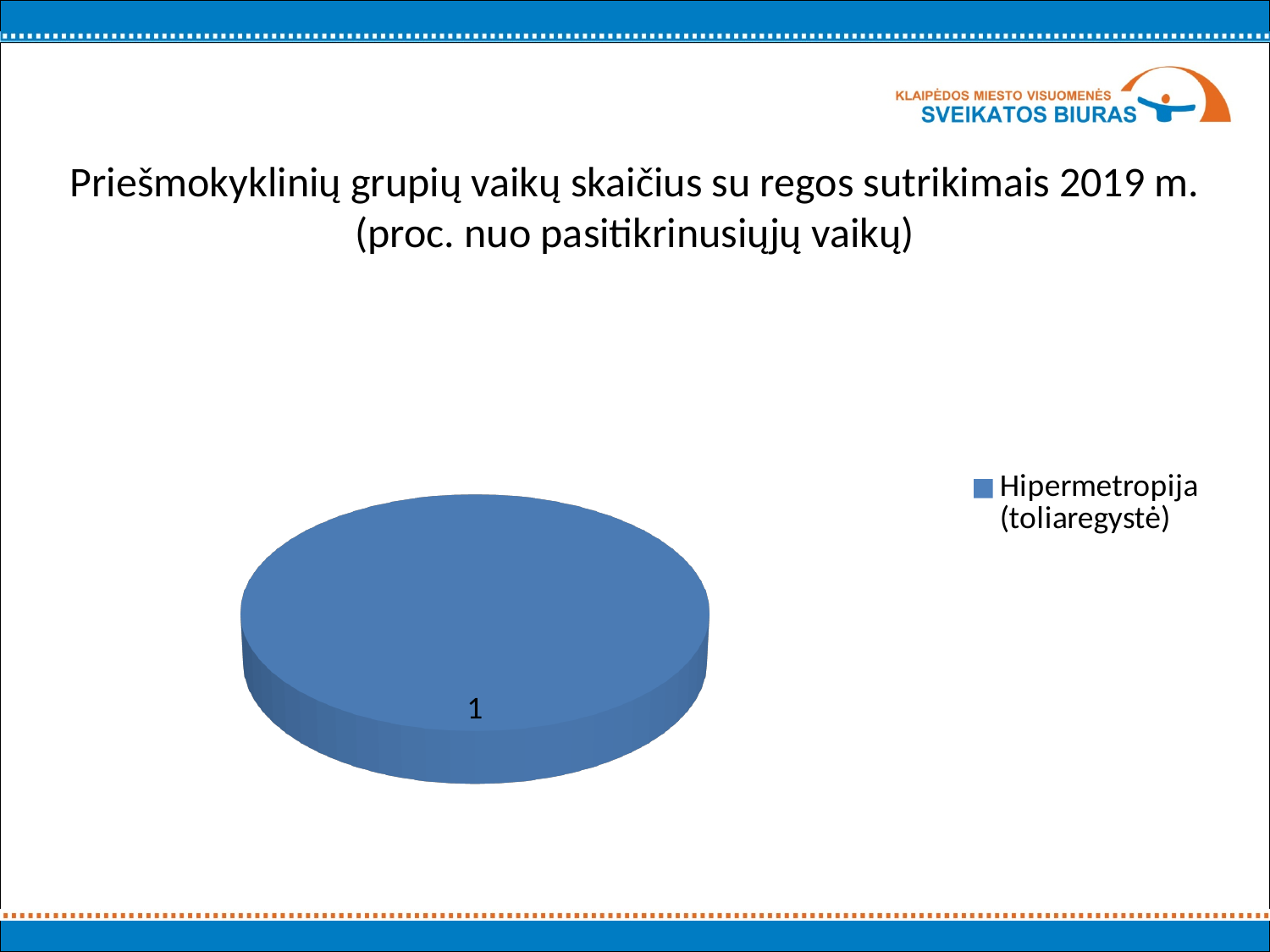
What share of the pie does the Hipermetropija (toliaregystė) slice take up? 100% What value is printed on the slice for Hipermetropija (toliaregystė)? 1 What kind of chart is shown on the slide? pie chart How many entries does the legend of the pie chart list? 1 What colour is the Hipermetropija (toliaregystė) slice in the pie chart? blue How many slices does the pie chart have? 1 What is the name of the category shown in the legend of the pie chart? Hipermetropija (toliaregystė)